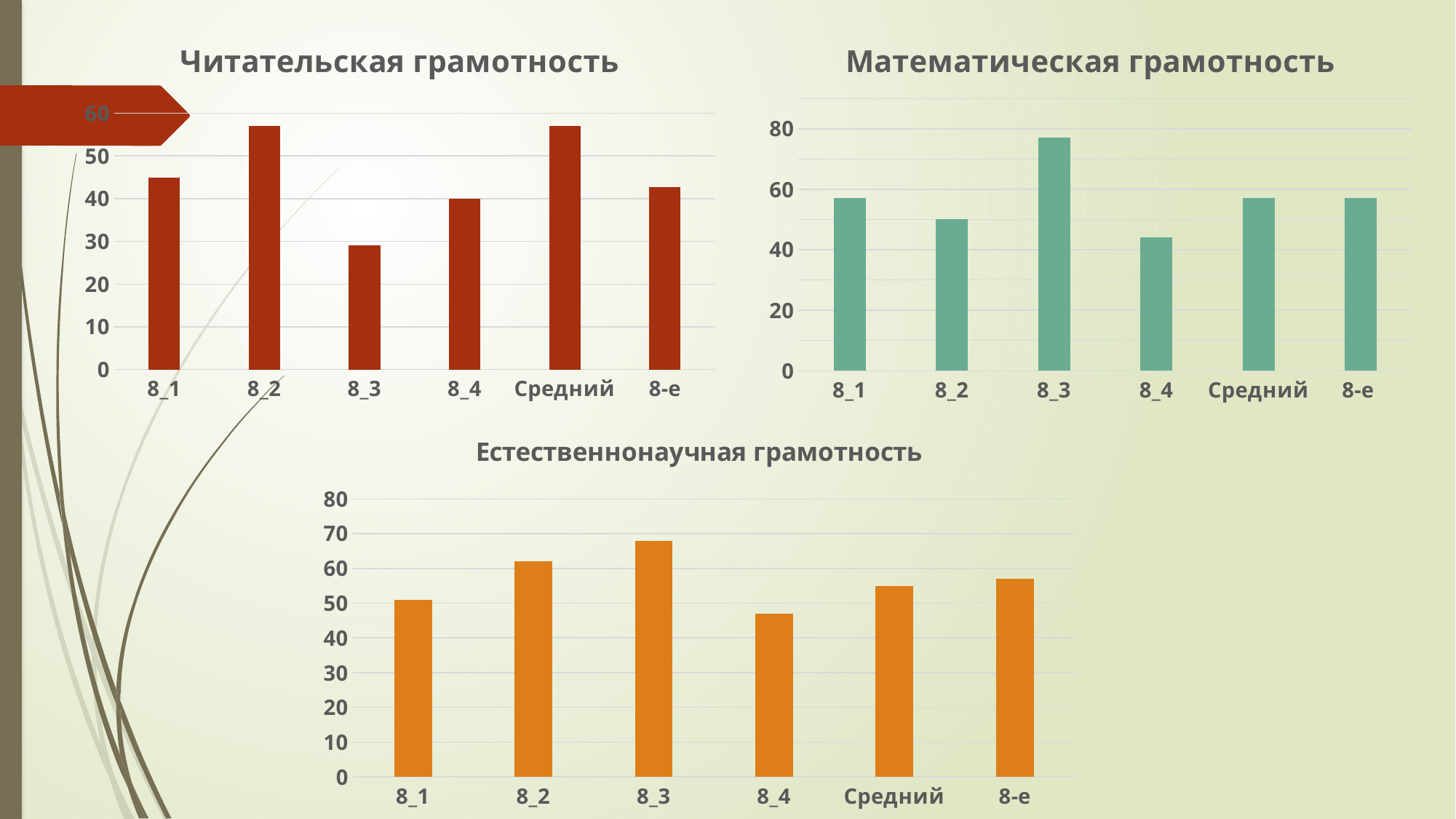
In the chart titled 'Читательская грамотность', which category has the lowest value? 8_3 In the chart titled 'Естественнонаучная грамотность', which category has the highest value? 8_3 In the chart titled 'Естественнонаучная грамотность', is the value for 8_4 greater or less than 50? less In the chart titled 'Математическая грамотность', which category has the lowest value? 8_4 In the chart titled 'Математическая грамотность', which category has the highest value? 8_3 In the chart titled 'Естественнонаучная грамотность', which category has the lowest value? 8_4 How many categories are shown on the x axis of the chart titled 'Естественнонаучная грамотность'? 6 What kind of chart is the chart titled 'Математическая грамотность'? bar chart In the chart titled 'Математическая грамотность', is the value for 8_3 greater or less than 60? greater In the chart titled 'Читательская грамотность', which is larger, the value for 8_1 or the value for 8_3? 8_1 In the chart titled 'Читательская грамотность', is the value for 8_2 greater or less than 50? greater